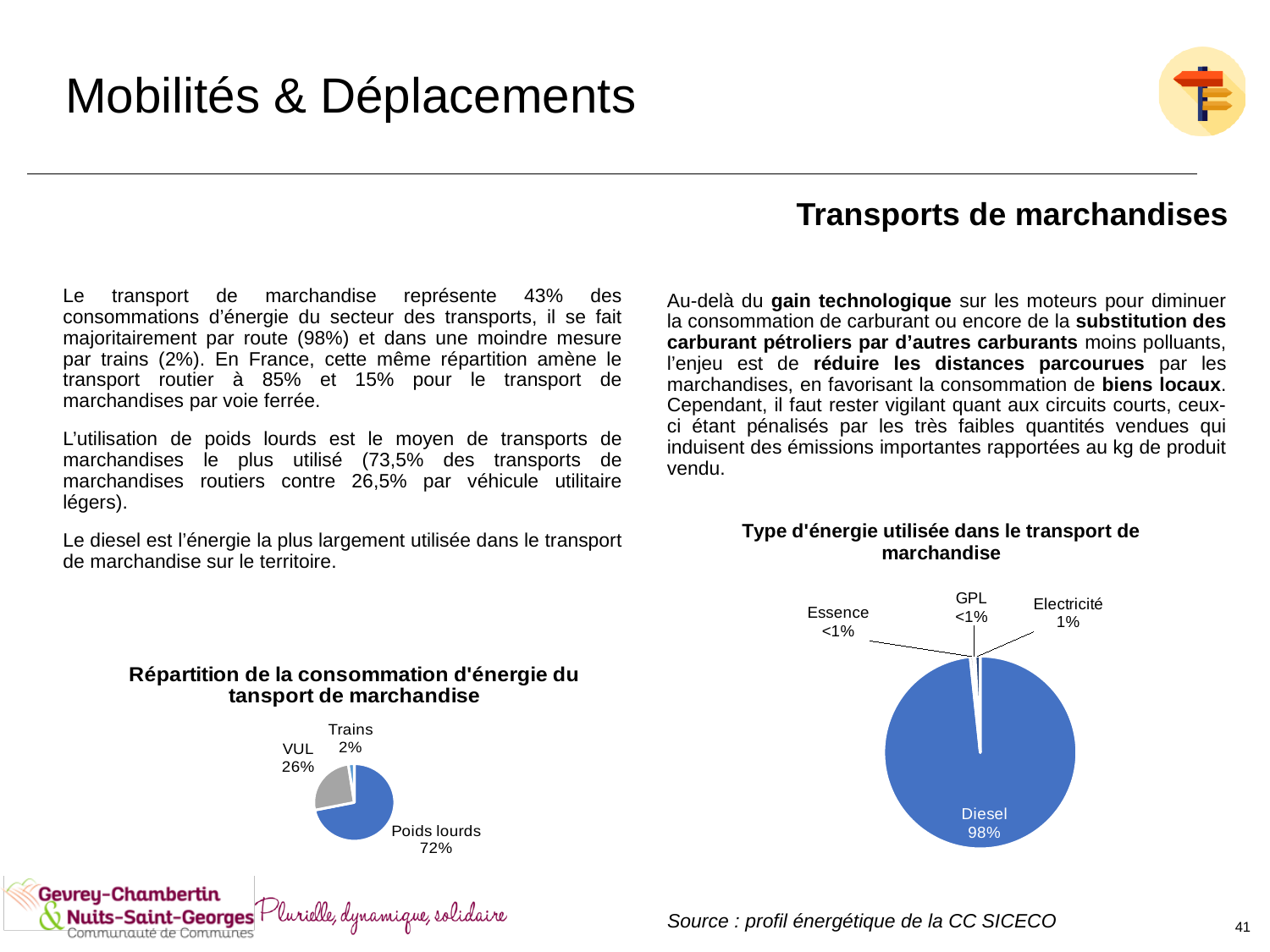
In the chart "Type d'énergie utilisée dans le transport de marchandise", what share is shown for Diesel? 98% In the chart "Répartition de la consommation d'énergie du tansport de marchandise", what share is shown for VUL? 26% In the chart "Répartition de la consommation d'énergie du tansport de marchandise", what is the difference between the shares of Poids lourds and VUL? 46 percentage points In the chart "Répartition de la consommation d'énergie du tansport de marchandise", what share is shown for Poids lourds? 72% In the chart "Type d'énergie utilisée dans le transport de marchandise", what share is shown for Electricité? 1% In the chart "Type d'énergie utilisée dans le transport de marchandise", which is larger, the share for Diesel or the share for Electricité? Diesel In the chart "Type d'énergie utilisée dans le transport de marchandise", what share is shown for GPL? <1% In the chart "Répartition de la consommation d'énergie du tansport de marchandise", which category has the smallest share? Trains What kind of chart is "Répartition de la consommation d'énergie du tansport de marchandise"? Pie chart In the chart "Type d'énergie utilisée dans le transport de marchandise", which category has the largest share? Diesel In the chart "Type d'énergie utilisée dans le transport de marchandise", how many categories are labelled? 4 In the chart "Répartition de la consommation d'énergie du tansport de marchandise", how many slices does the pie have? 3